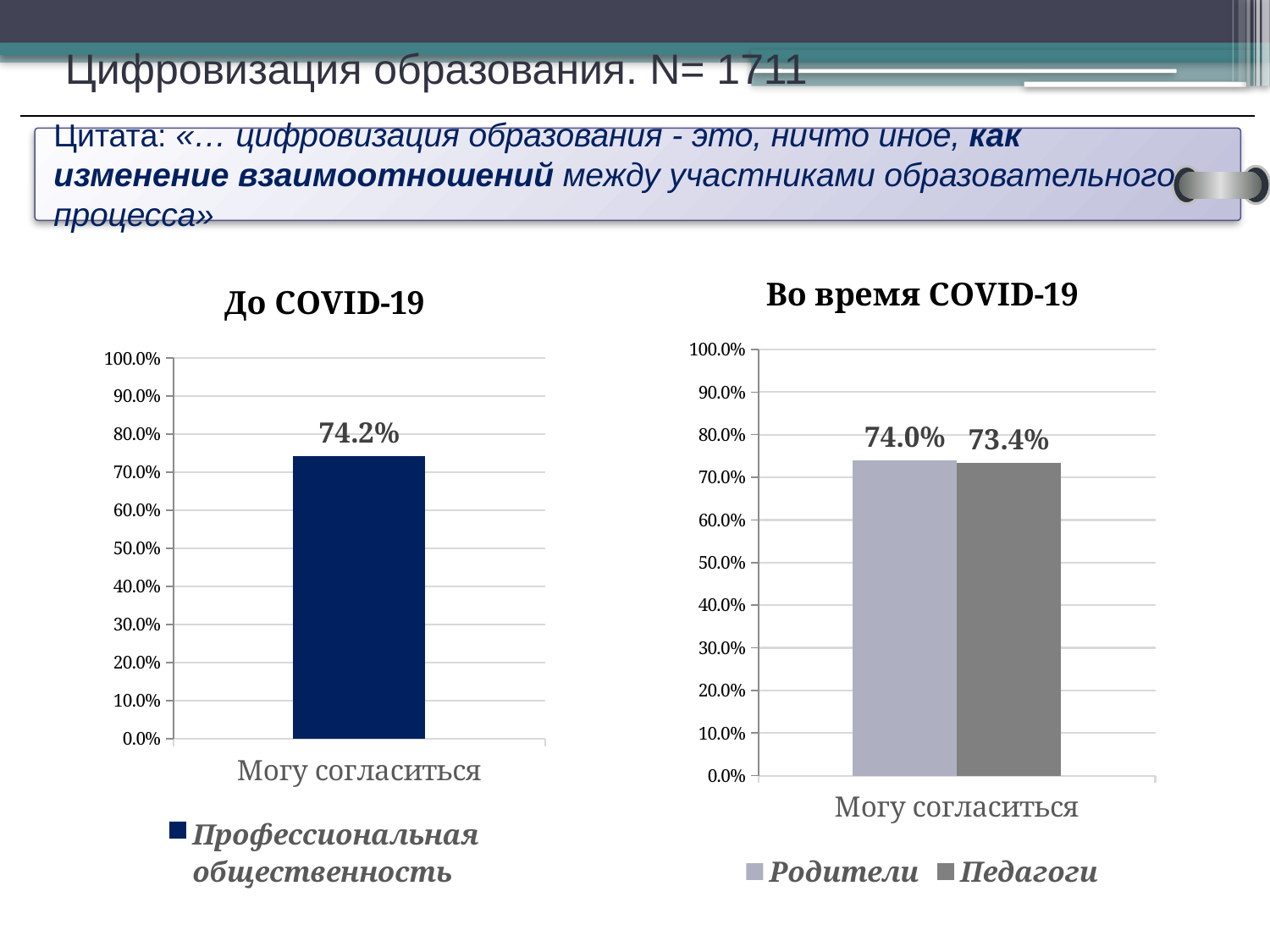
What kind of chart is the chart titled "До COVID-19"? Bar chart In the chart titled "Во время COVID-19", which series has the higher value, Родители or Педагоги? Родители How many series does the legend of the chart titled "До COVID-19" list? 1 What is the category label on the x axis of the chart titled "Во время COVID-19"? Могу согласиться In the chart titled "До COVID-19", is the value for Профессиональная общественность greater or less than 70.0%? greater In the chart titled "До COVID-19", what is the value for Профессиональная общественность? 74.2% How many series does the legend of the chart titled "Во время COVID-19" list? 2 What is the title of the chart on the right side of the slide? Во время COVID-19 In the chart titled "Во время COVID-19", is the value for Педагоги greater or less than 80.0%? less In the chart titled "Во время COVID-19", what is the difference between the values for Родители and Педагоги? 0.6% In the chart titled "Во время COVID-19", what is the value for Педагоги? 73.4% In the chart titled "Во время COVID-19", what is the value for Родители? 74.0%